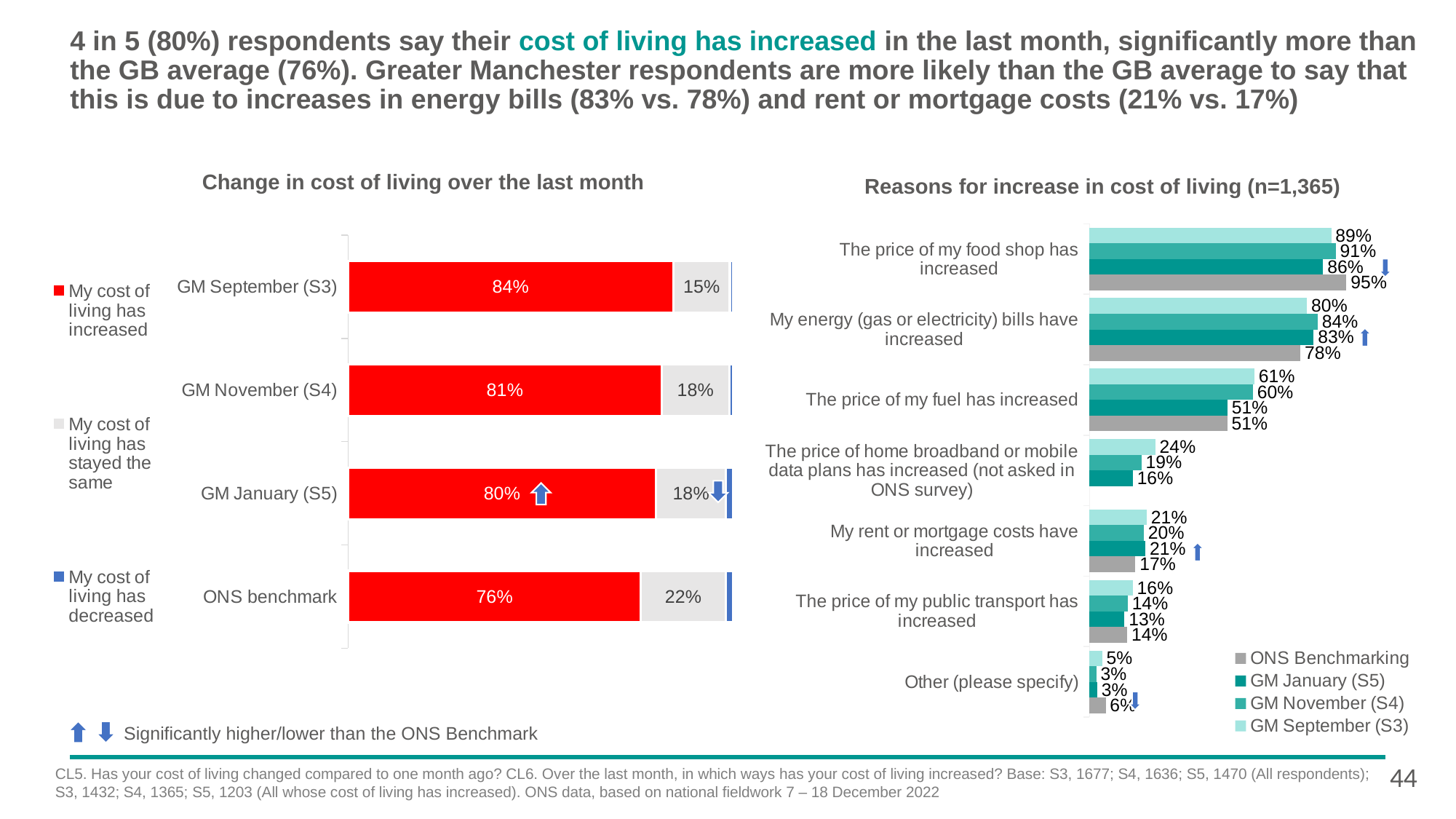
In the 'Reasons for increase in cost of living' chart, what is the difference between the GM January (S5) and ONS Benchmarking values for 'My rent or mortgage costs have increased'? 4 percentage points What kind of chart is 'Change in cost of living over the last month'? Stacked bar chart In the 'Change in cost of living over the last month' chart, how many series does the legend list? 3 In the 'Change in cost of living over the last month' chart, what is the difference between the 'increased' share for GM September (S3) and the ONS benchmark? 8 percentage points In the 'Change in cost of living over the last month' chart, which category has the highest share saying their cost of living has increased? GM September (S3) In the 'Change in cost of living over the last month' chart, what percentage of GM January (S5) respondents say their cost of living has increased? 80% In the 'Reasons for increase in cost of living' chart, which reason has the lowest GM January (S5) value? Other (please specify) In the 'Reasons for increase in cost of living' chart, how many reason categories are shown? 7 In the 'Reasons for increase in cost of living' chart, what is the GM January (S5) value for 'My energy (gas or electricity) bills have increased'? 83% In the 'Change in cost of living over the last month' chart, what percentage of ONS benchmark respondents say their cost of living has stayed the same? 22% In the 'Reasons for increase in cost of living' chart, is the GM September (S3) value for 'The price of my fuel has increased' larger or smaller than the GM January (S5) value? Larger In the 'Reasons for increase in cost of living' chart, what is the ONS Benchmarking value for 'The price of my food shop has increased'? 95%